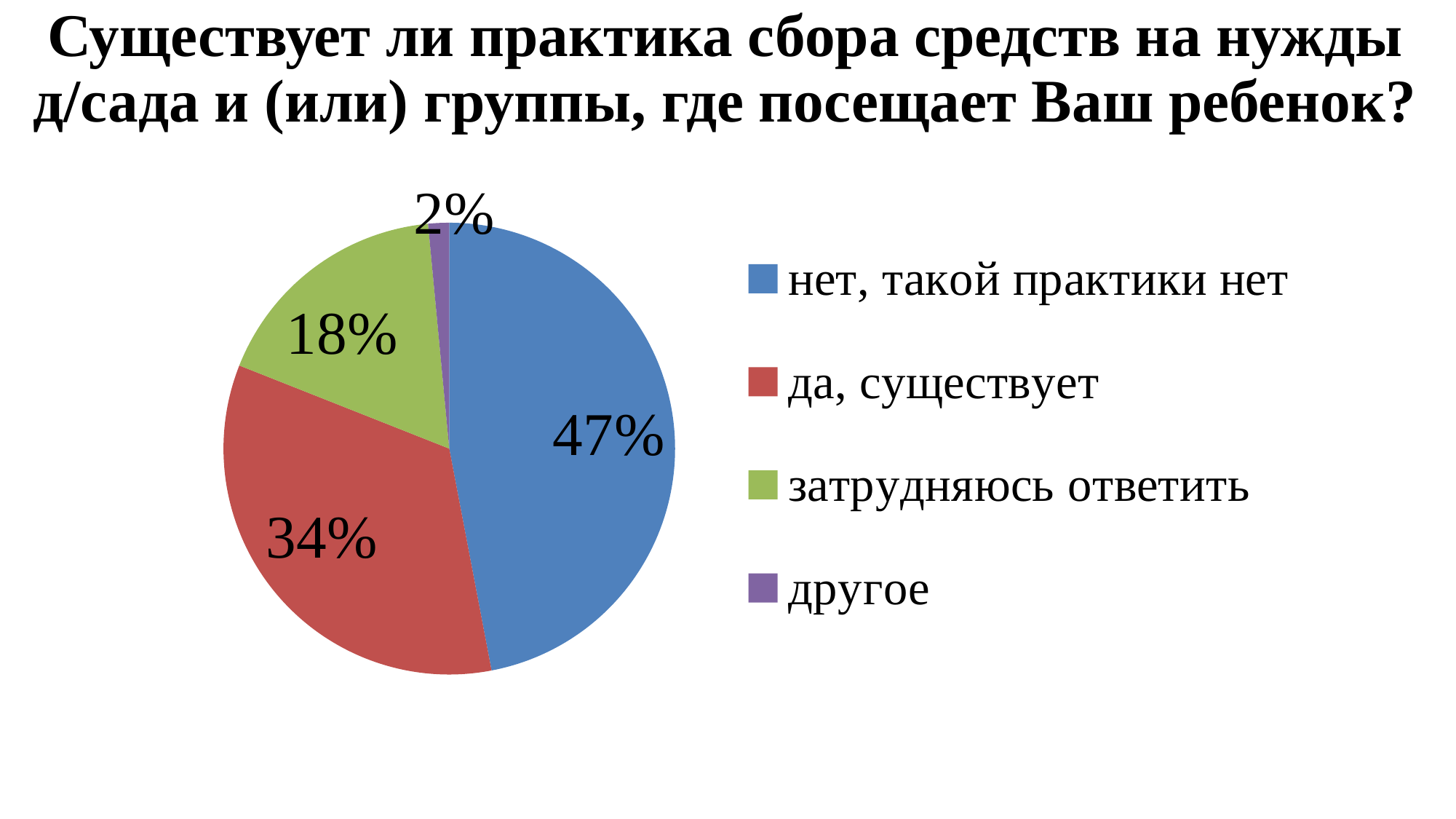
What kind of chart is shown on the slide? pie chart Which category has the largest slice? нет, такой практики нет What is the difference between "затрудняюсь ответить" and "другое"? 16% Which category has the smallest slice? другое What is the difference between "нет, такой практики нет" and "да, существует"? 13% How many categories does the legend list? 4 What is the value for "другое"? 2% Which is larger, "да, существует" or "затрудняюсь ответить"? да, существует What share of the pie does "нет, такой практики нет" have? 47% What is the value for "затрудняюсь ответить"? 18% What colour is the slice for "затрудняюсь ответить"? green What is the value for "да, существует"? 34%